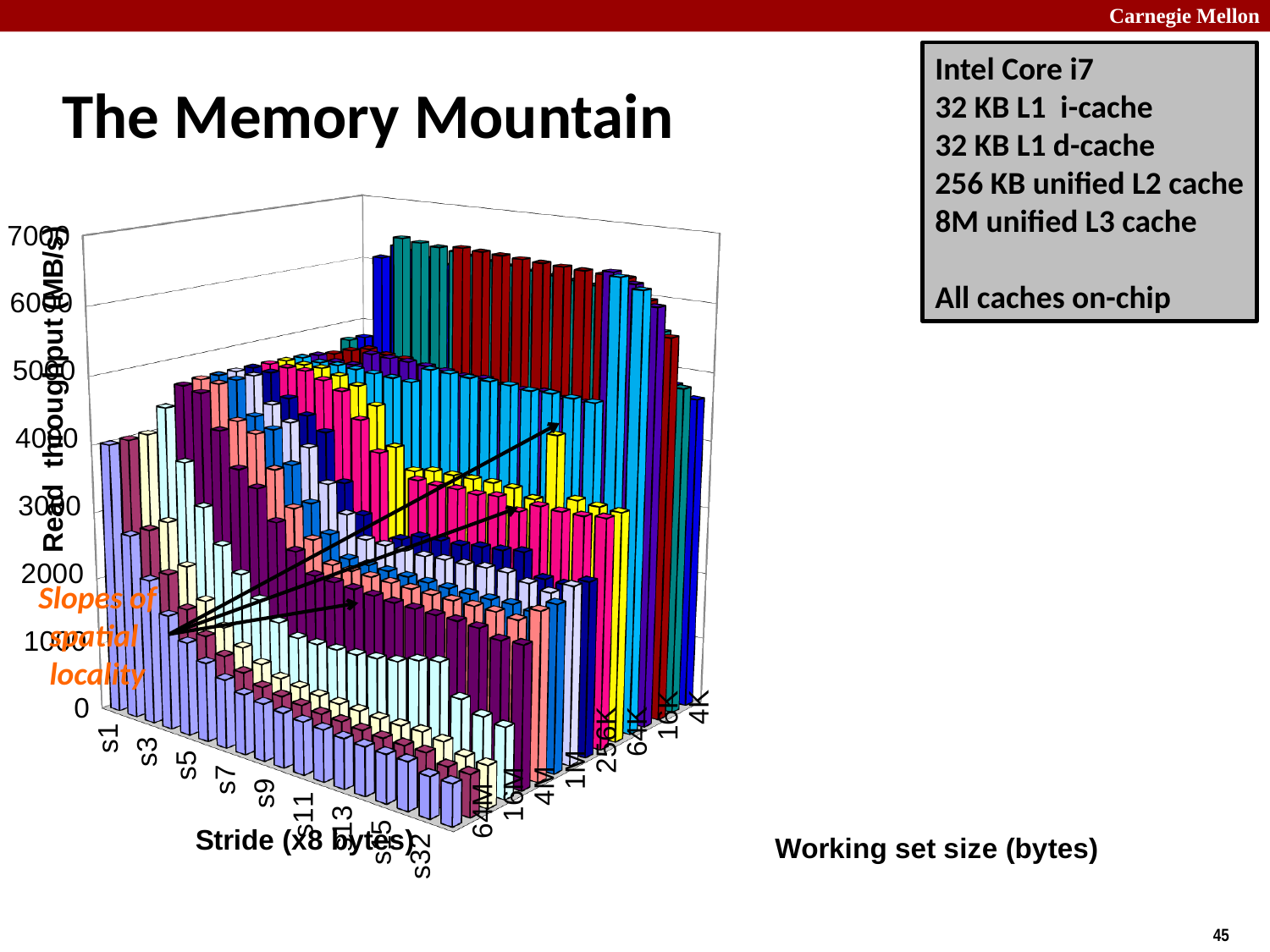
Is the highest read throughput shown on the chart greater or less than 5000 MB/s? greater What kind of chart is shown on the slide? 3D bar chart For the 64M working set size, does read throughput rise or fall as the stride increases from s1 to s32? fall Is the read throughput for stride s1 at a 64M working set greater or less than 6000 MB/s? less What quantity is plotted on the vertical axis of the chart, including its unit? Read throughput (MB/s) What is the title of the chart on the slide? The Memory Mountain Which working set size has the higher read throughput at stride s1: 4K or 64M? 4K